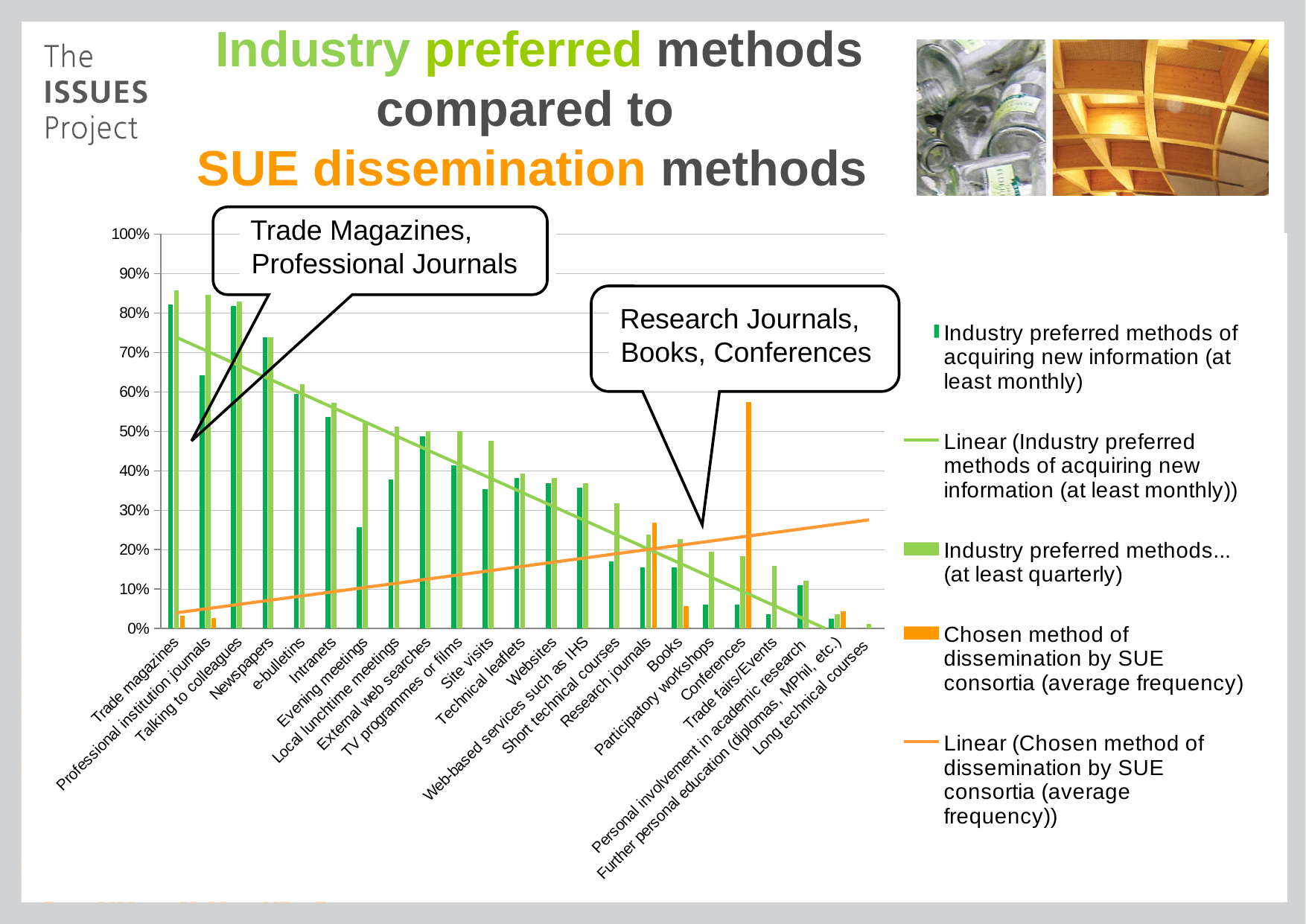
Is the 'Industry preferred methods of acquiring new information (at least monthly)' value for Trade magazines greater or less than 70%? greater Is the 'Chosen method of dissemination by SUE consortia' value for Research journals greater or less than 20%? greater What kind of chart is shown on the slide? bar chart Is the 'Chosen method of dissemination by SUE consortia' value for Conferences greater or less than 50%? greater Does the linear trendline for the chosen method of dissemination by SUE consortia rise or fall from left to right along the x axis? rise Which category has the highest value for the 'Chosen method of dissemination by SUE consortia (average frequency)' series? Conferences How many entries does the chart's legend list? 5 Which has the larger 'Chosen method of dissemination by SUE consortia' value, Conferences or Books? Conferences Does the linear trendline for the industry preferred methods (at least monthly) rise or fall from left to right along the x axis? fall How many categories are shown along the x axis of the chart? 23 Which categories does the callout 'Trade Magazines, Professional Journals' point to on the chart? Trade magazines and Professional institution journals